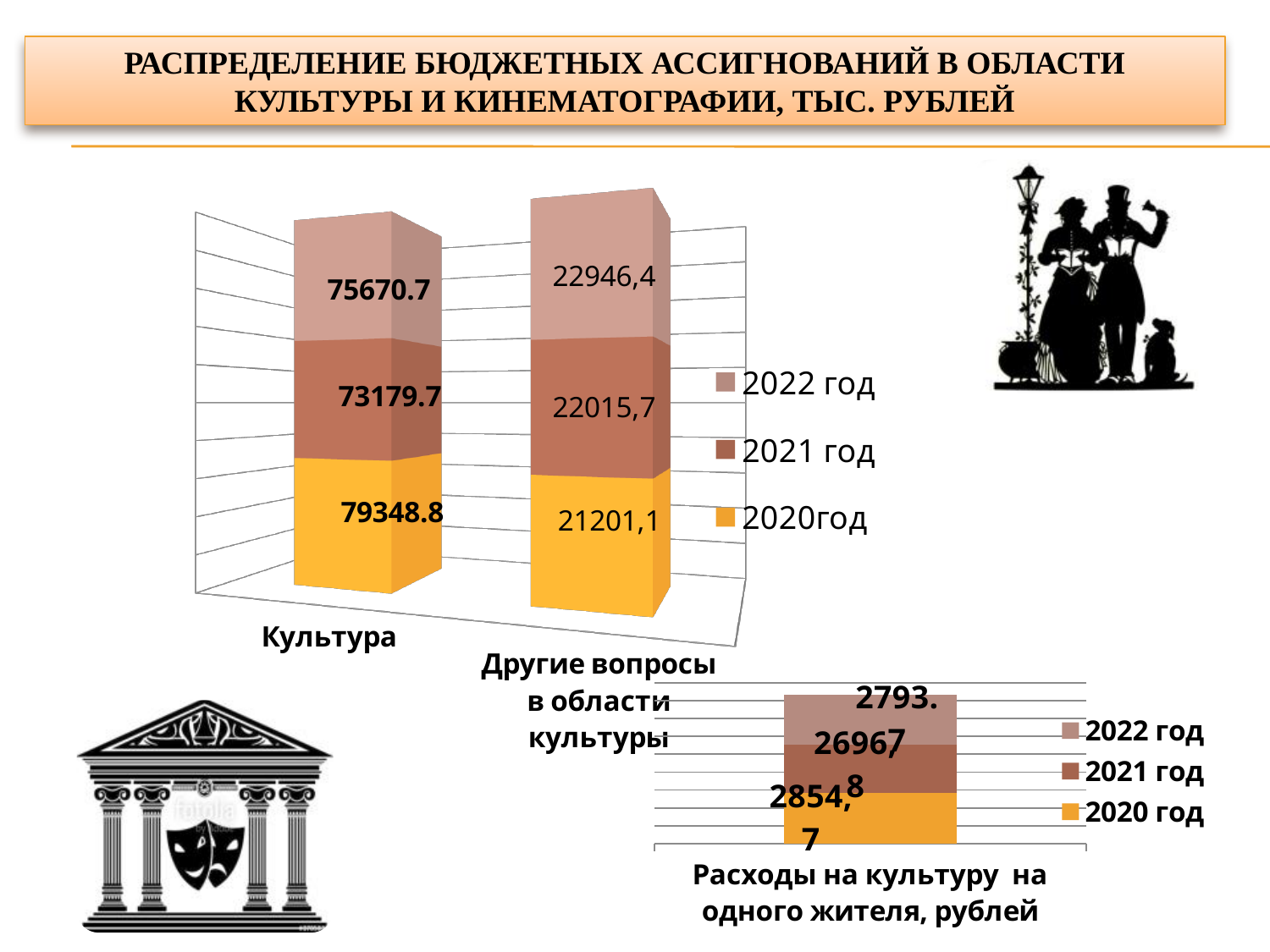
In the upper stacked bar chart, which is larger for Культура: the 2022 год value or the 2021 год value? 2022 год In the upper stacked bar chart, what is the value for 2020год in the Культура category? 79348.8 In the upper stacked bar chart, how many series does the legend list? 3 In the upper stacked bar chart, what is the value for 2022 год in the category Другие вопросы в области культуры? 22946,4 In the upper stacked bar chart, what is the value for 2020год in the category Другие вопросы в области культуры? 21201,1 What kind of chart is the lower chart titled Расходы на культуру на одного жителя, рублей? Stacked bar chart In the upper stacked bar chart, what is the value for 2022 год in the Культура category? 75670.7 In the upper stacked bar chart, what is the value for 2021 год in the Культура category? 73179.7 In the upper stacked bar chart, which year has the highest value in the Культура category? 2020год In the upper stacked bar chart, what is the value for 2021 год in the category Другие вопросы в области культуры? 22015,7 In the upper stacked bar chart, which year has the lowest value in the category Другие вопросы в области культуры? 2020год In the upper stacked bar chart, how many categories are shown on the x axis? 2